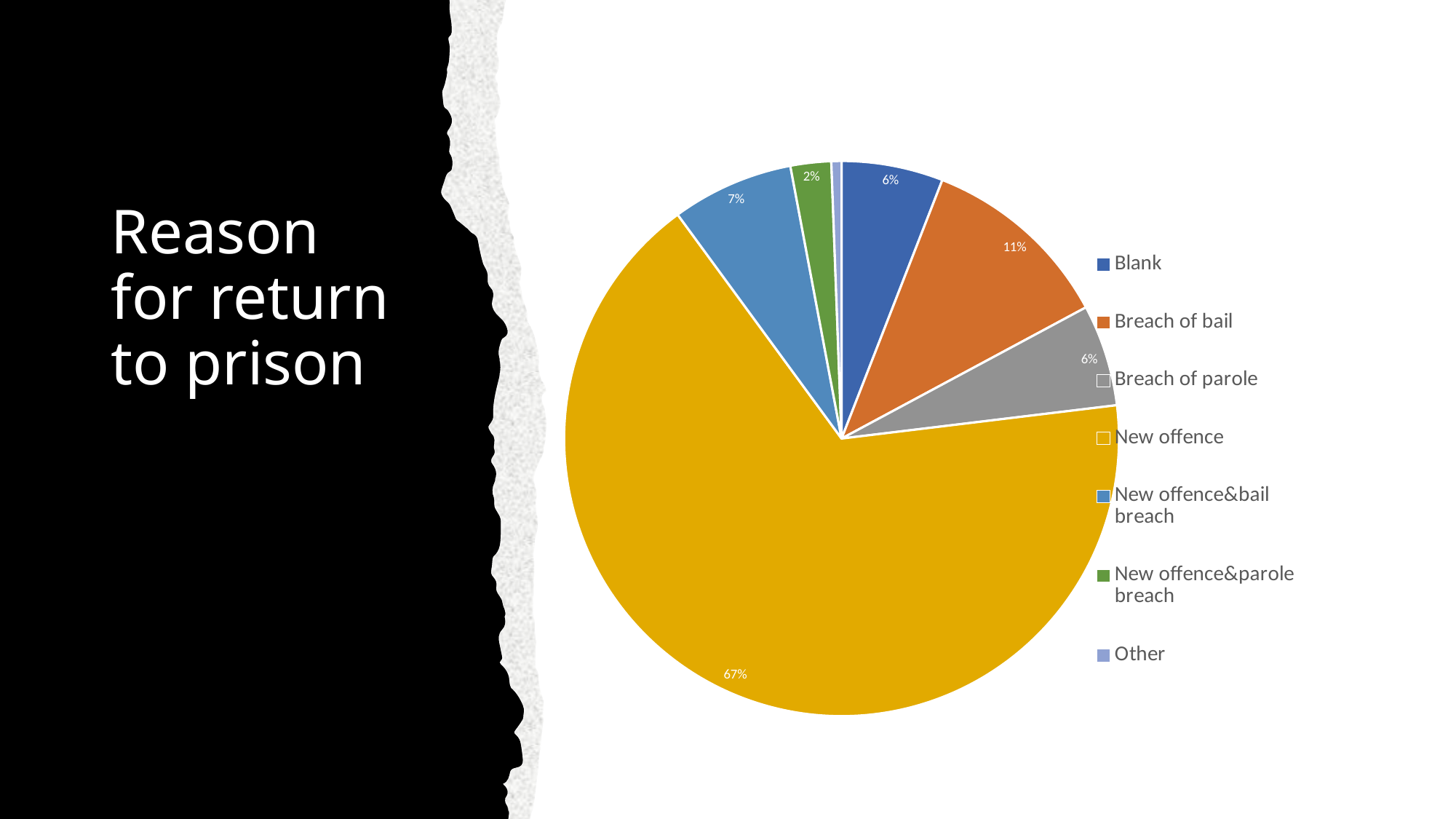
What percentage is shown for New offence&bail breach? 7% Which category has the smallest slice of the pie? Other What share of the pie does New offence account for? 67% What kind of chart is shown on the slide? pie chart What colour is the New offence slice? yellow Which category has the largest slice of the pie? New offence What percentage is shown for Breach of bail? 11% How many categories does the legend list? 7 What is the difference in percentage points between New offence and Breach of bail? 56 Which is larger, Breach of bail or New offence&bail breach? Breach of bail What percentage is shown for New offence&parole breach? 2% What percentage is shown for Blank? 6%